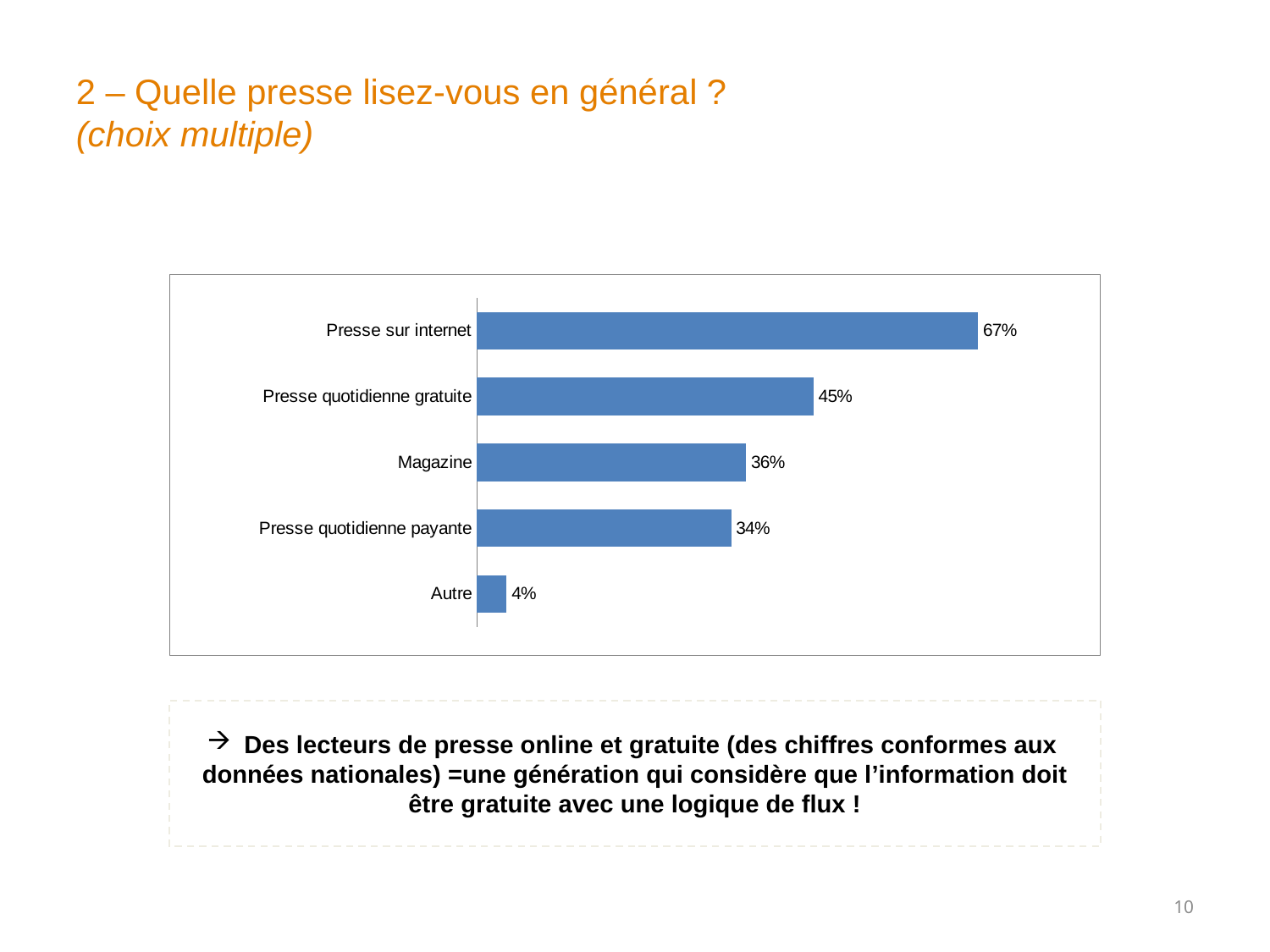
What is the value for Presse sur internet? 67% What is the value for Presse quotidienne payante? 34% What is the value for Autre? 4% What is the difference between the values for Presse sur internet and Presse quotidienne gratuite? 22% How many categories are shown in the chart? 5 Which is larger, the value for Presse quotidienne gratuite or the value for Magazine? Presse quotidienne gratuite What is the value for Magazine? 36% Which category has the highest value? Presse sur internet What is the value for Presse quotidienne gratuite? 45% What is the difference between the values for Magazine and Presse quotidienne payante? 2% What kind of chart is shown on the slide? Bar chart Which category has the lowest value? Autre